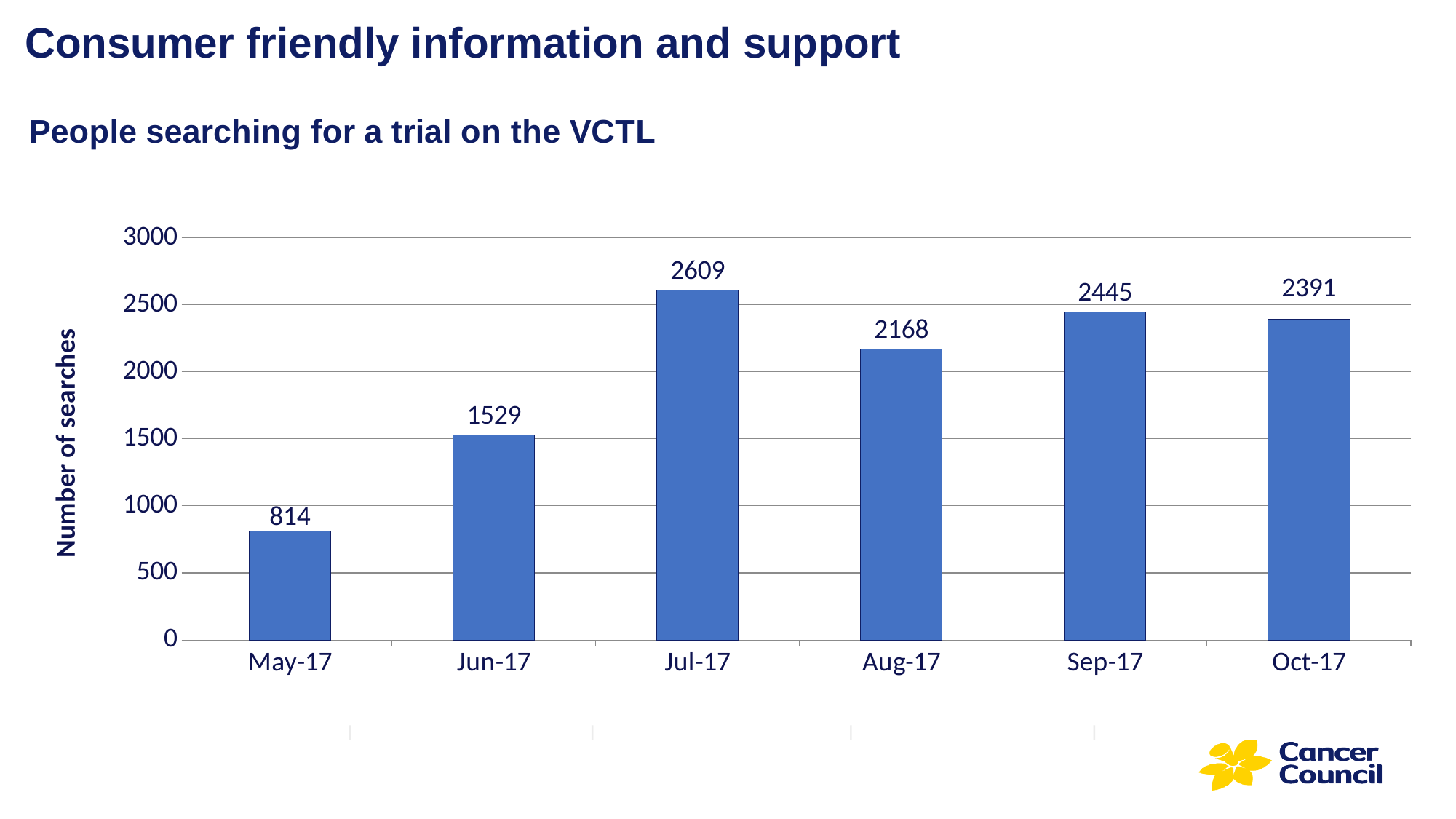
Which month has the highest number of searches? Jul-17 What is the difference in searches between Jul-17 and Aug-17? 441 What is the difference in searches between Jun-17 and May-17? 715 What is the number of searches for Jul-17? 2609 What kind of chart is shown on the slide? bar chart Which has more searches, Sep-17 or Oct-17? Sep-17 How many months are shown on the x axis? 6 What is the number of searches for Sep-17? 2445 Which month has the lowest number of searches? May-17 Is the value for Aug-17 greater or less than 2000? greater What is the label of the y axis? Number of searches What is the number of searches for May-17? 814